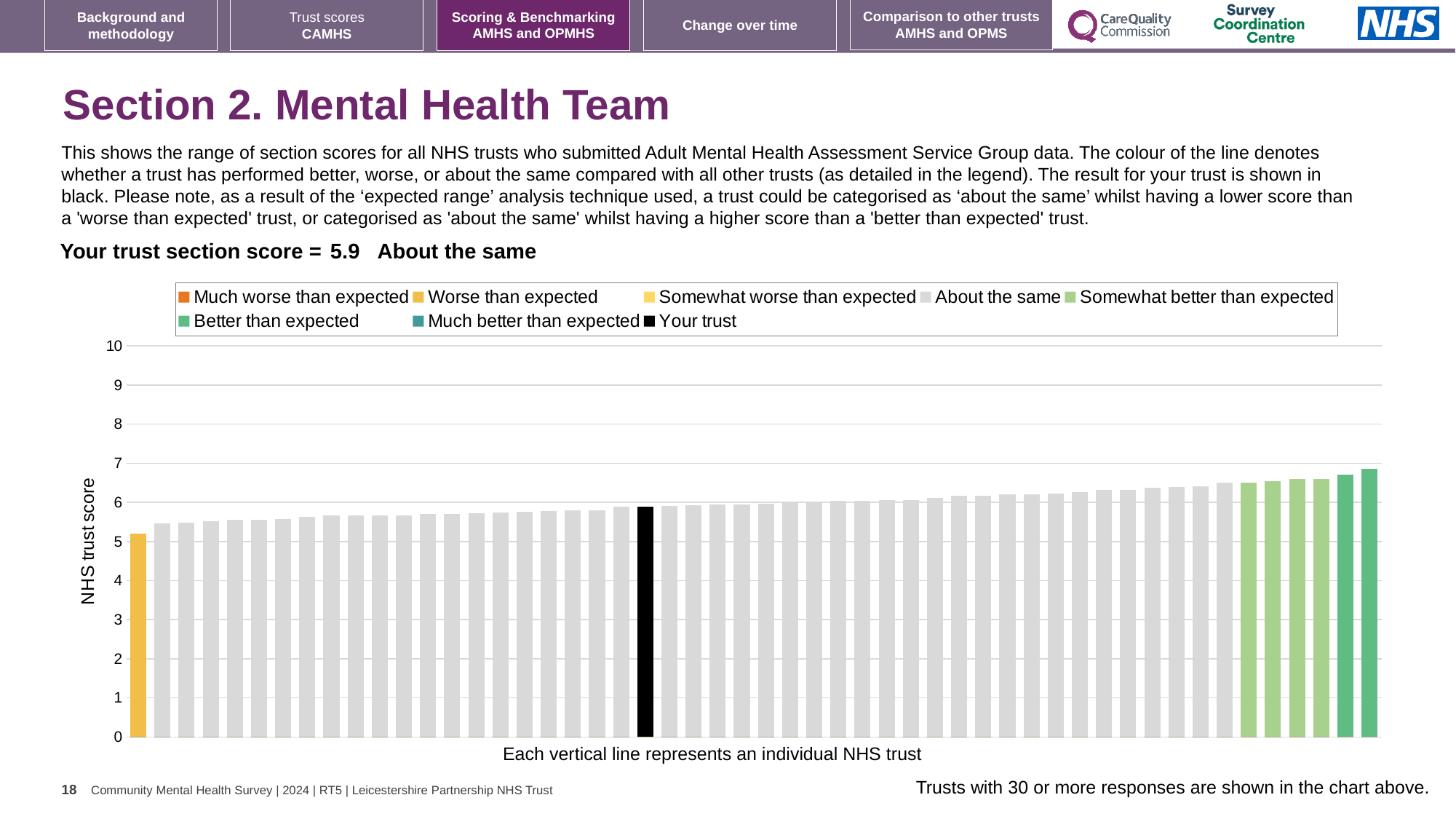
Do the bar values rise or fall from left to right along the x axis? rise Is the value of the black 'Your trust' bar greater or less than 5? greater Is the value of the leftmost (lowest) bar greater or less than 6? less What kind of chart is shown on the slide? bar chart What is the label on the vertical axis of the chart? NHS trust score Is the value of the rightmost (highest) bar greater or less than 7? less What is the section score for your trust shown on the slide? 5.9 Which benchmarking category is your trust placed in for this section? About the same Which legend category does the highest bar in the chart belong to? Better than expected How many bars are coloured as 'Somewhat better than expected'? 4 How many entries does the chart legend list? 8 How many bars are coloured as 'Worse than expected'? 1